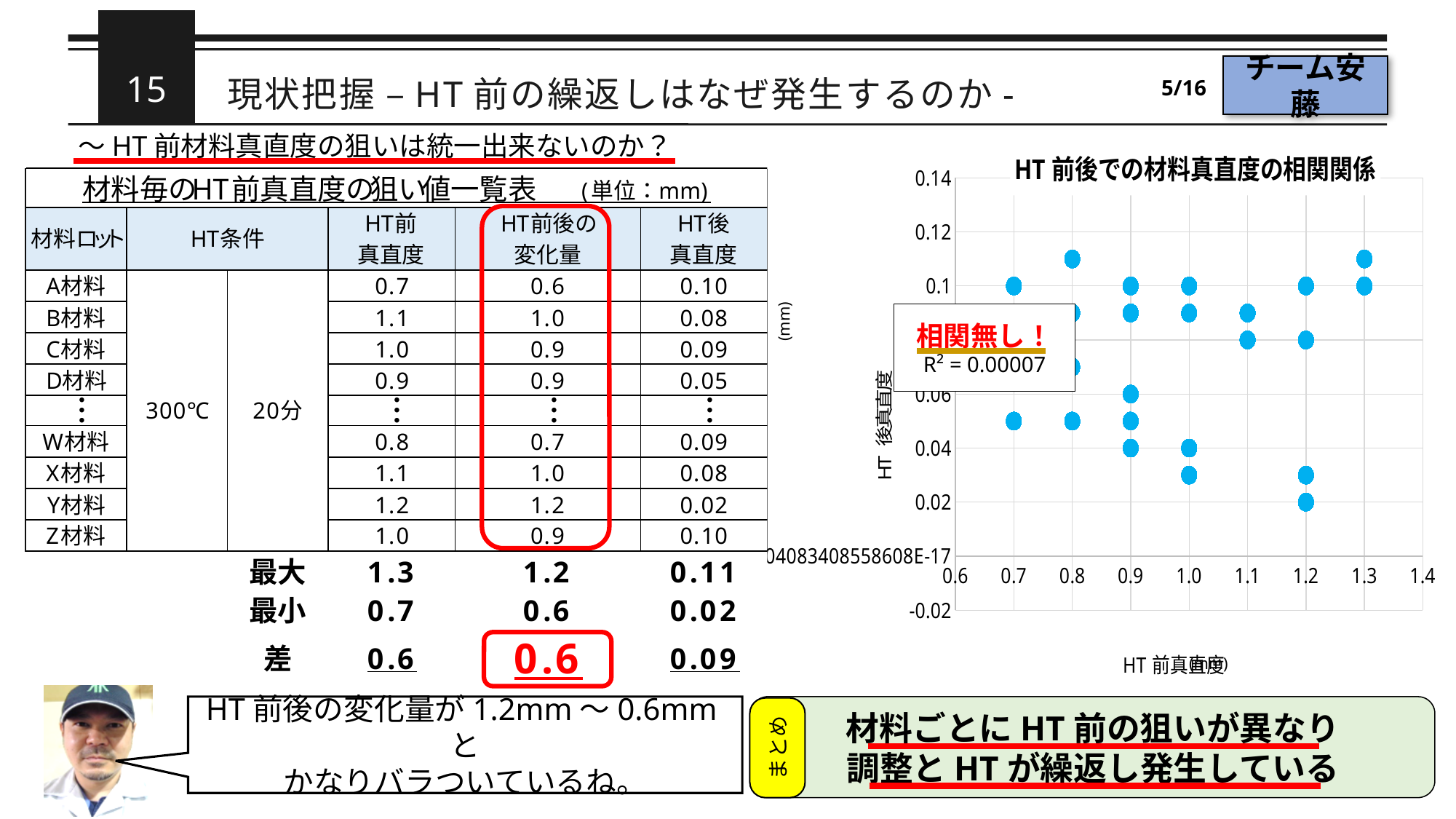
What is the title of the chart on the right side of the slide? HT前後での材料真直度の相関関係 In the scatter chart, is the smallest plotted x value greater or less than 0.6? greater In the scatter chart, is the highest plotted y value greater or less than 0.12? less Do the y values in the scatter chart show a clear rising or falling trend as x increases? no clear trend What is the label of the x axis of the scatter chart? HT前真直度 What R² value is printed on the scatter chart? R² = 0.00007 In the scatter chart, is the largest plotted x value greater or less than 1.4? less What kind of chart is shown on the right side of the slide? scatter chart